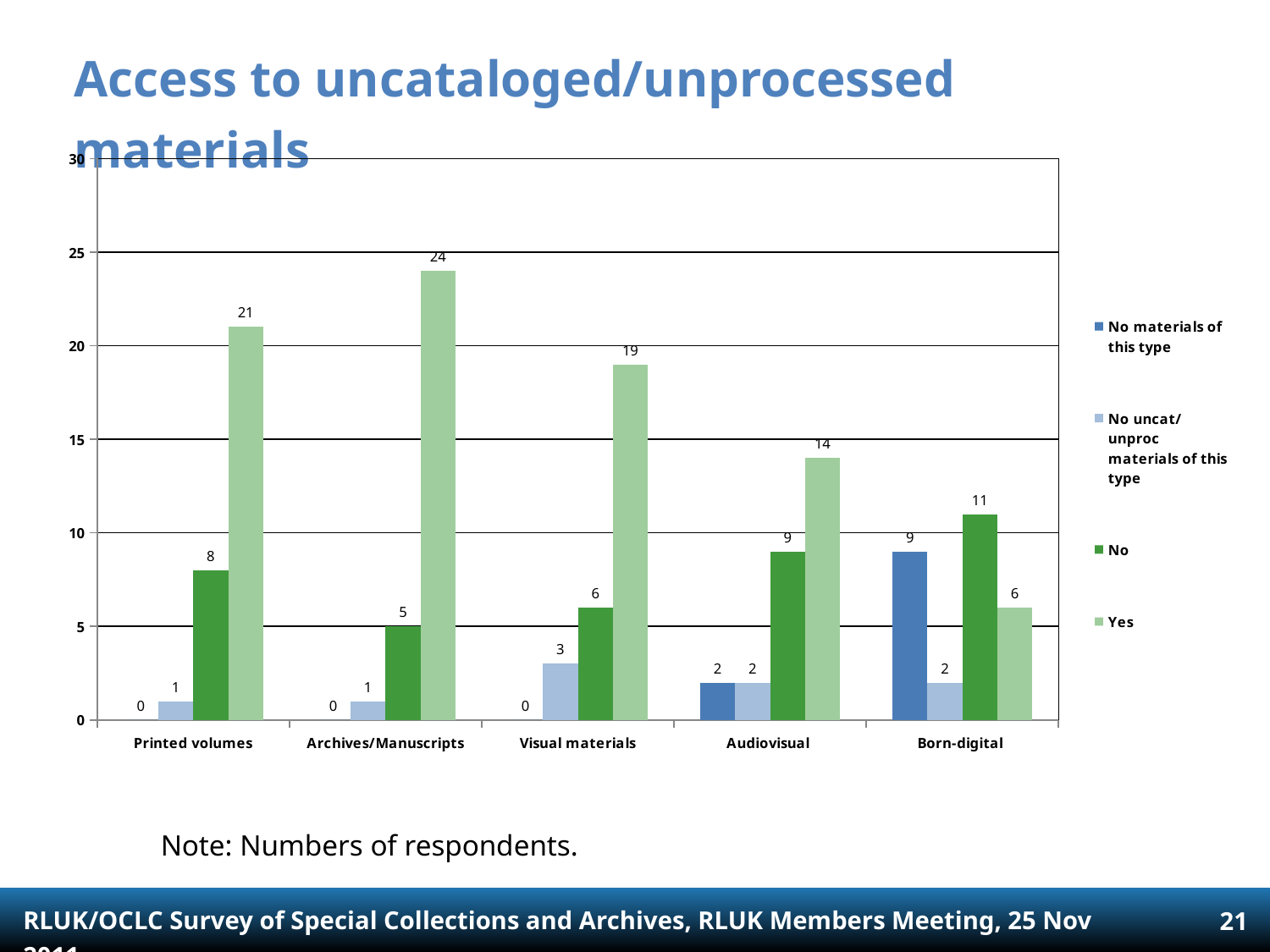
What is the value for "No materials of this type" for Audiovisual? 2 How many series does the legend list? 4 What is the value for "No" for Born-digital? 11 Which category has the lowest "Yes" value? Born-digital What is the value for "Yes" for Archives/Manuscripts? 24 What is the value for "No uncat/unproc materials of this type" for Visual materials? 3 What kind of chart is shown on the slide? Bar chart How many categories are shown on the x axis? 5 Do the "Yes" values rise or fall from Visual materials to Born-digital? Fall What is the difference between the "Yes" values for Printed volumes and Visual materials? 2 Which category has the highest "Yes" value? Archives/Manuscripts Which is larger for Born-digital: the "No" value or the "Yes" value? No